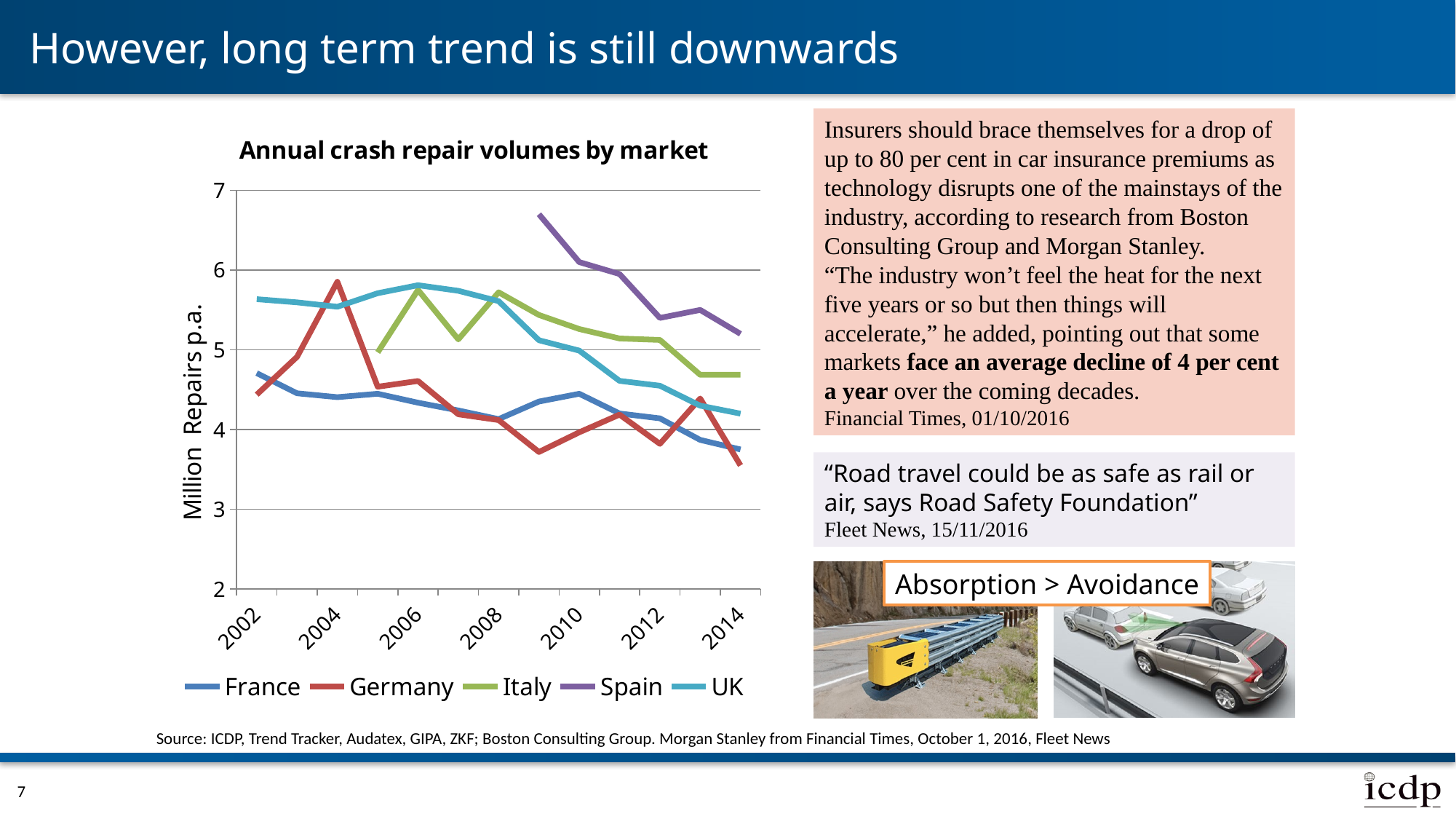
What kind of chart is shown on the slide? line chart Is the value for Spain in 2009 greater or less than 6? greater What is the label on the vertical axis of the chart? Million Repairs p.a. In 2008, which has the larger crash repair volume, Italy or France? Italy Is the value for the UK in 2002 greater or less than 5? greater Which market has the lowest crash repair volume in 2010? Germany Is the value for France in 2014 greater or less than 4? less Which market has the highest crash repair volume in 2014? Spain How many series does the legend of the chart list? 5 What is the title of the chart? Annual crash repair volumes by market Does the UK line generally rise or fall from 2002 to 2014? fall